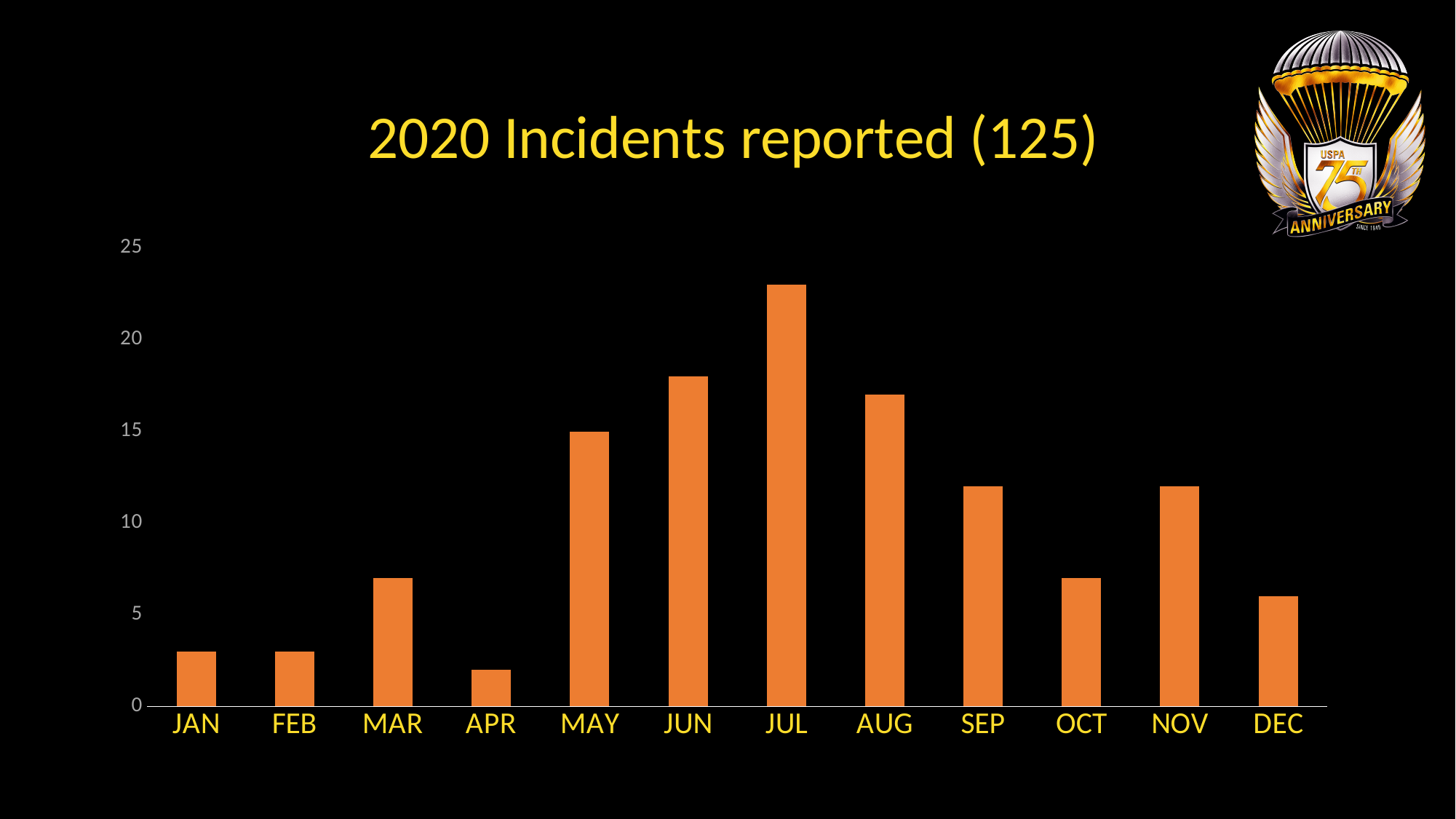
How many months are shown on the x axis of the chart? 12 Is the value for JUL greater or less than 20? greater What colour are the bars in the chart? orange Is the value for SEP greater or less than 10? greater Is the value for JUN greater or less than 20? less Which month has the highest number of incidents reported? JUL Do the values rise or fall from JAN to JUL? rise Which month has the lowest number of incidents reported? APR Which month has more incidents reported, MAY or SEP? MAY What is the title of the chart? 2020 Incidents reported (125) What kind of chart is shown on the slide? bar chart